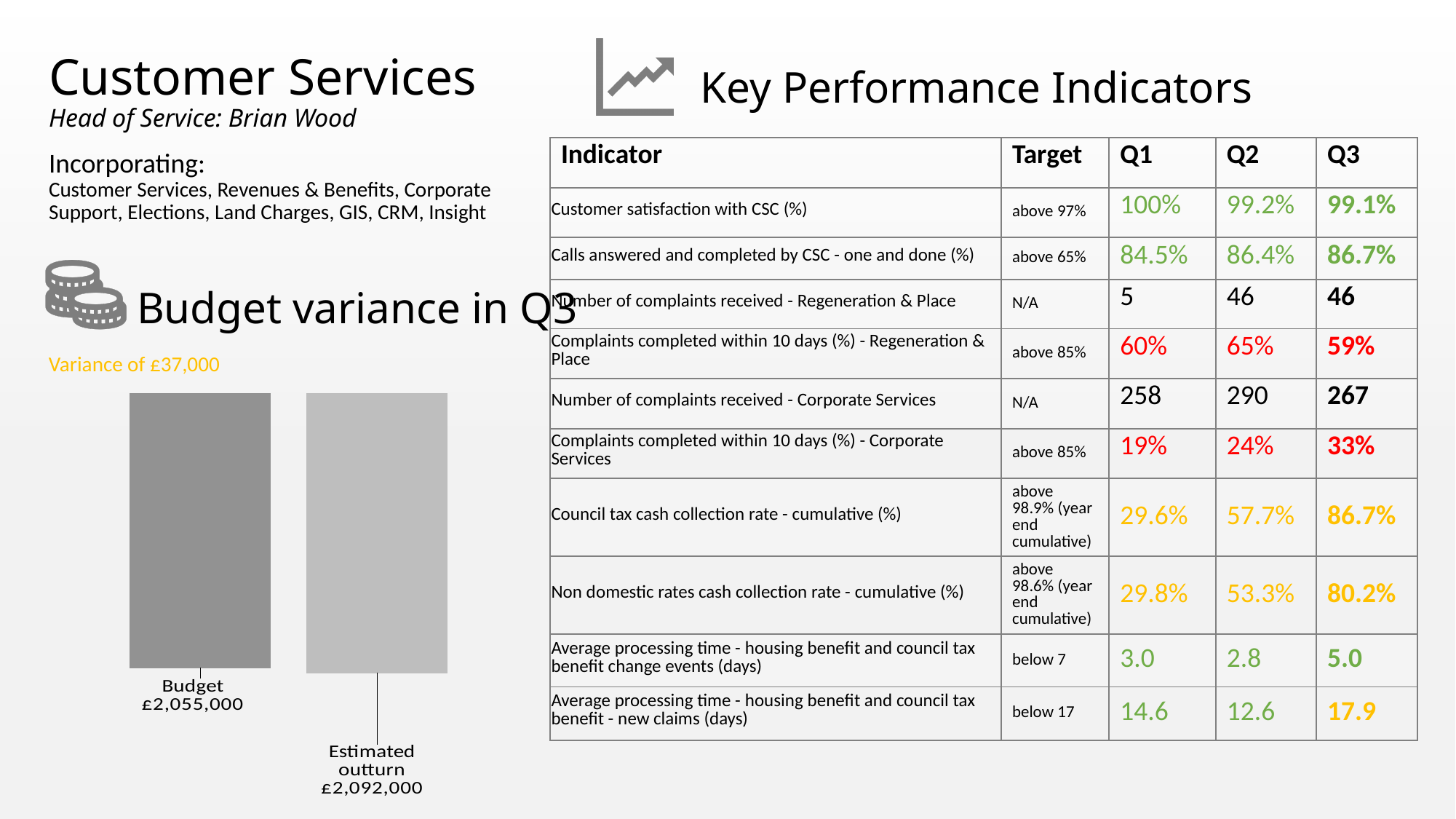
How many bars are plotted in the Budget variance in Q3 chart? 2 What variance amount is stated above the Budget variance in Q3 chart? Variance of £37,000 In the Budget variance in Q3 chart, which category has the lower labelled value? Budget In the Budget variance in Q3 chart, what is the value of the Estimated outturn bar? £2,092,000 In the Budget variance in Q3 chart, which category has the higher labelled value? Estimated outturn In the Budget variance in Q3 chart, what is the difference between the Estimated outturn and the Budget? £37,000 In the Budget variance in Q3 chart, which is larger according to the printed labels: Budget or Estimated outturn? Estimated outturn What is the title of the bar chart on the slide? Budget variance in Q3 What kind of chart is the Budget variance in Q3 chart? Bar chart In the Budget variance in Q3 chart, what is the value of the Budget bar? £2,055,000